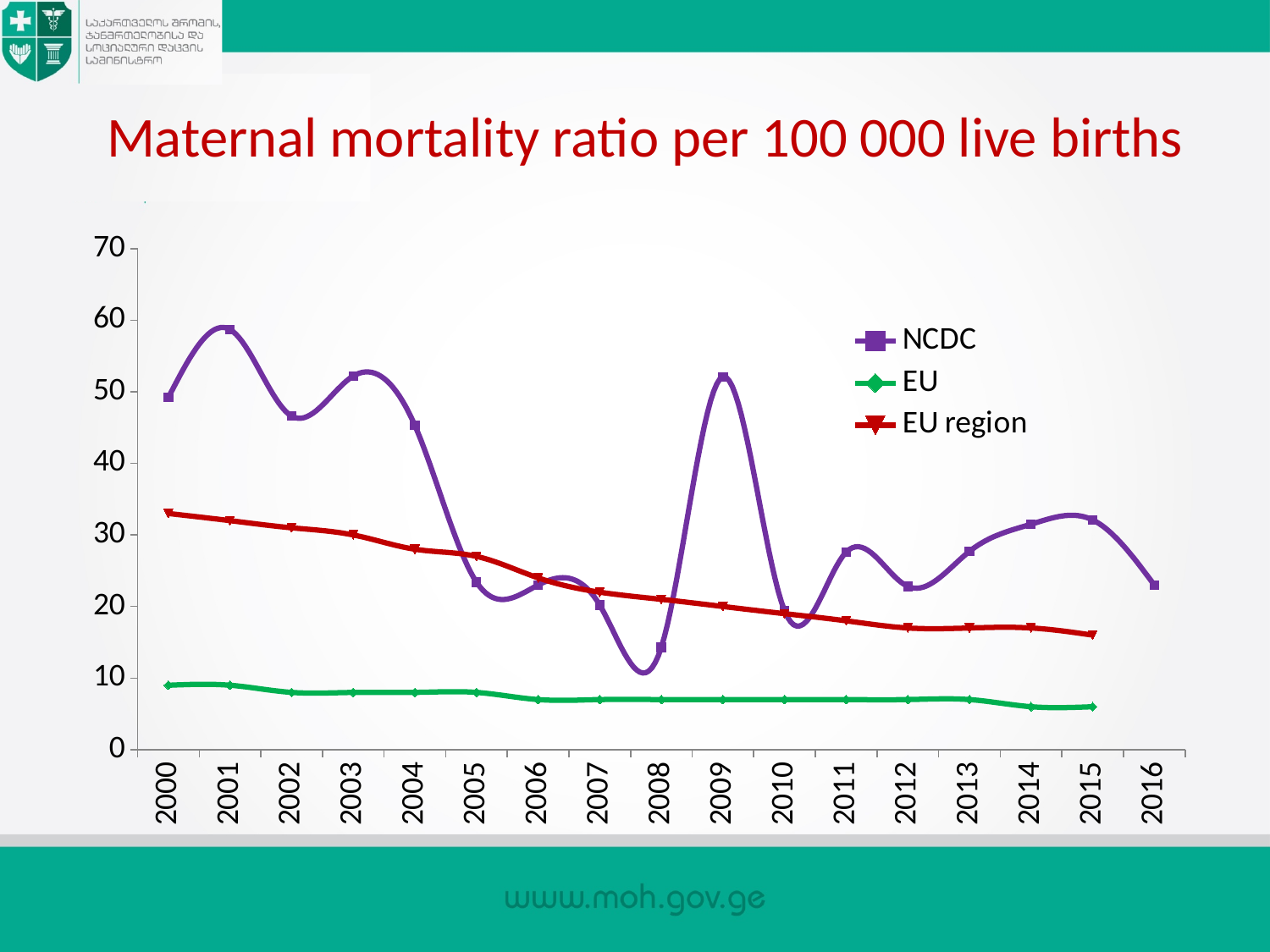
How many series does the legend list? 3 How many years are shown on the x axis? 17 In which year does the NCDC series reach its lowest value? 2008 What type of chart is shown on the slide? line chart Is the EU region value for 2000 greater or less than 30? greater Is the NCDC value for 2008 greater or less than 20? less Is the NCDC value for 2001 greater or less than 50? greater In which year does the NCDC series reach its highest value? 2001 What is the title of the chart? Maternal mortality ratio per 100 000 live births In 2008, which is larger: the NCDC value or the EU region value? EU region Which series is drawn in green? EU Does the EU region series rise or fall from 2000 to 2015? fall